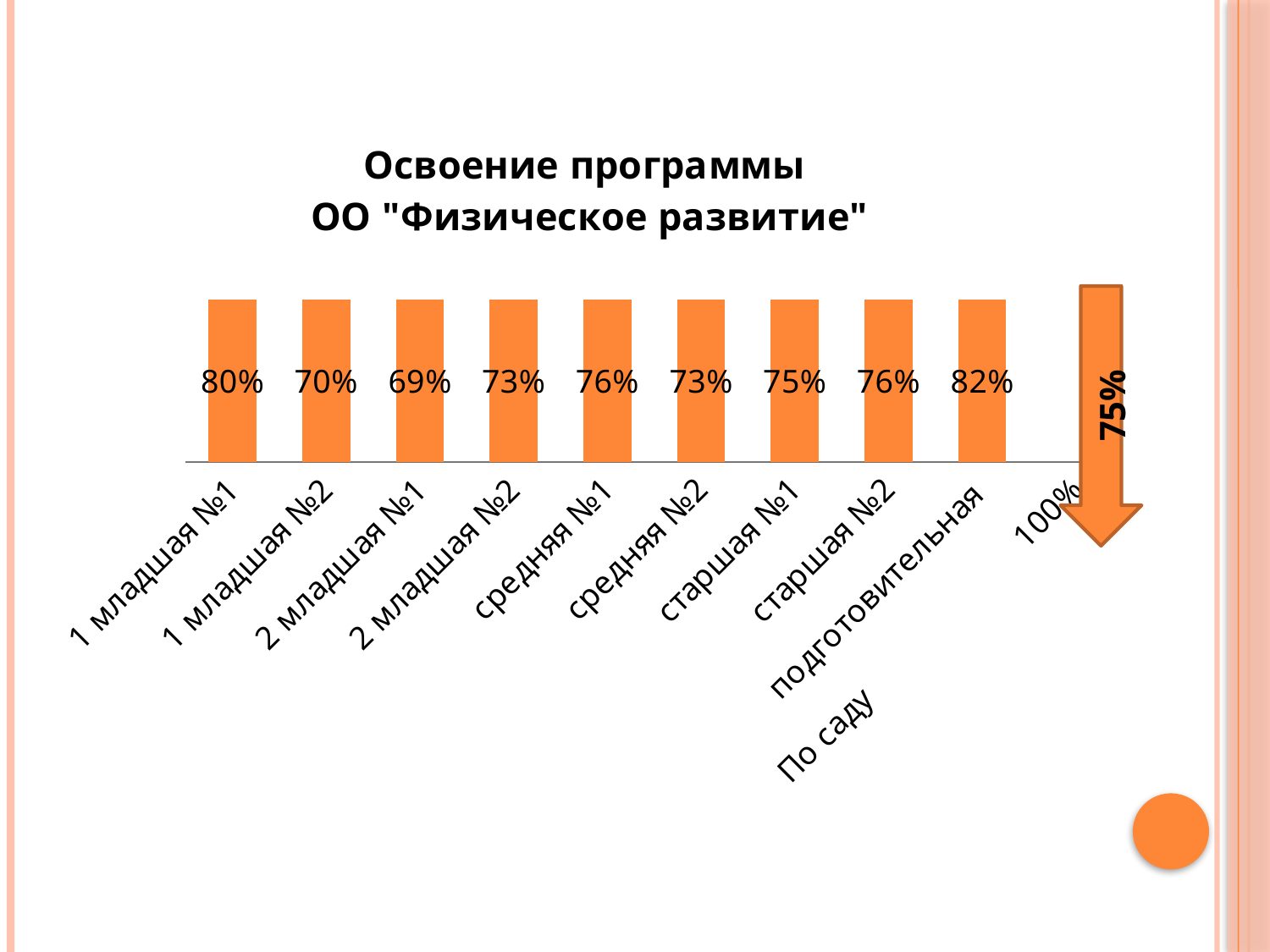
What is the value shown for подготовительная? 82% What kind of chart is shown on the slide? Bar chart Which has a larger value, 1 младшая №1 or старшая №2? 1 младшая №1 What is the value shown for 1 младшая №1? 80% How many categories are shown on the x axis of the chart? 10 Which group has the highest value according to the data labels? подготовительная What is the value shown for старшая №1? 75% Which group has the lowest value according to the data labels? 2 младшая №1 What is the difference between the values for 1 младшая №1 and 1 младшая №2? 10% What is the title of the chart? Освоение программы ОО "Физическое развитие" What is the value shown for средняя №1? 76% What is the difference between the values for подготовительная and 2 младшая №1? 13%